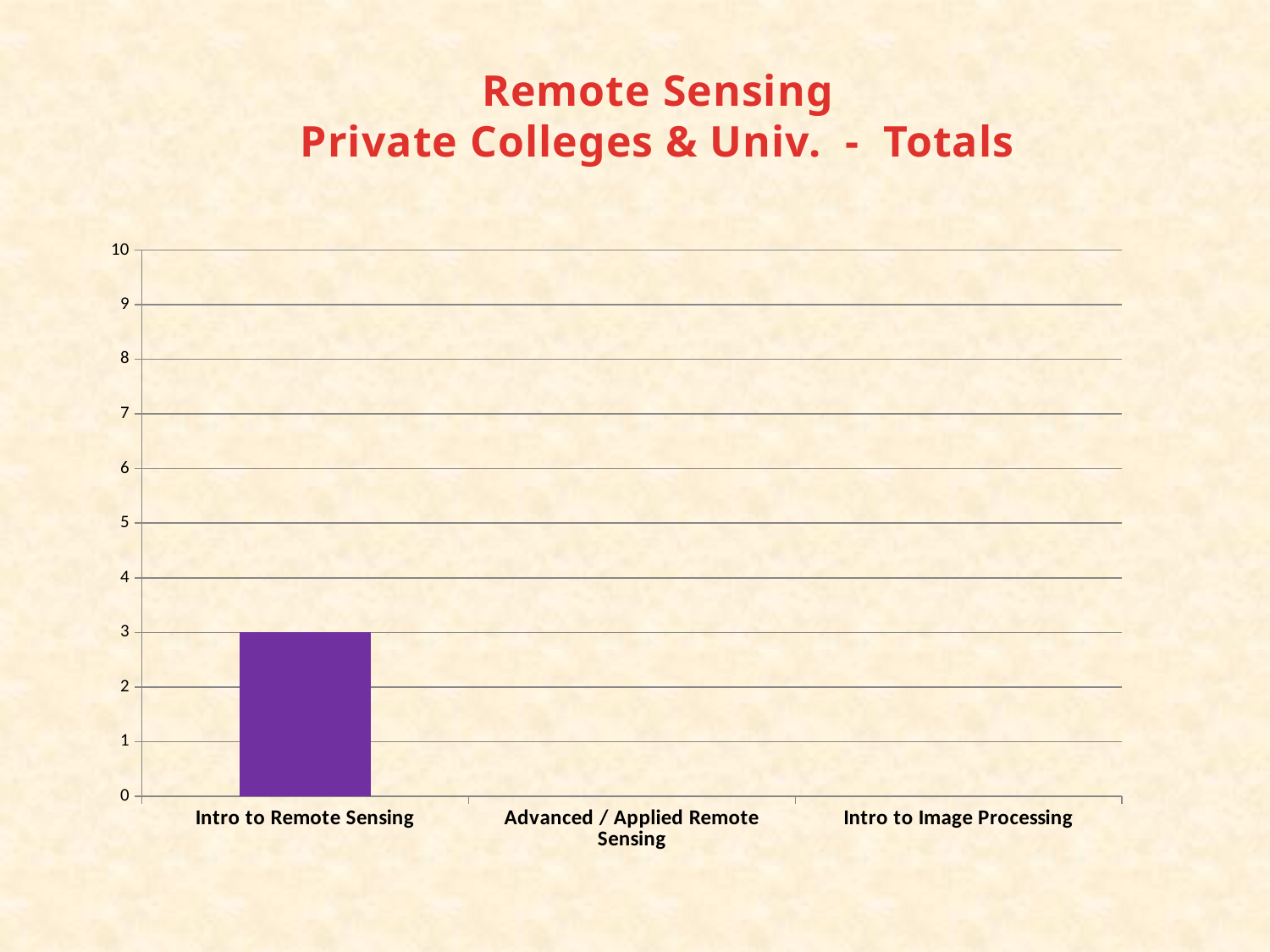
Which is larger, the value for Intro to Remote Sensing or the value for Intro to Image Processing? Intro to Remote Sensing Which category has the highest value? Intro to Remote Sensing Is the value for Intro to Image Processing greater or less than 2? less What kind of chart is shown on the slide? Bar chart What is the maximum value shown on the y axis? 10 How many categories are shown on the x axis? 3 What is the title of the chart? Remote Sensing Private Colleges & Univ. - Totals Is the value for Intro to Remote Sensing greater or less than 5? less Is the value for Advanced / Applied Remote Sensing greater or less than 1? less What is the value for Intro to Remote Sensing? 3